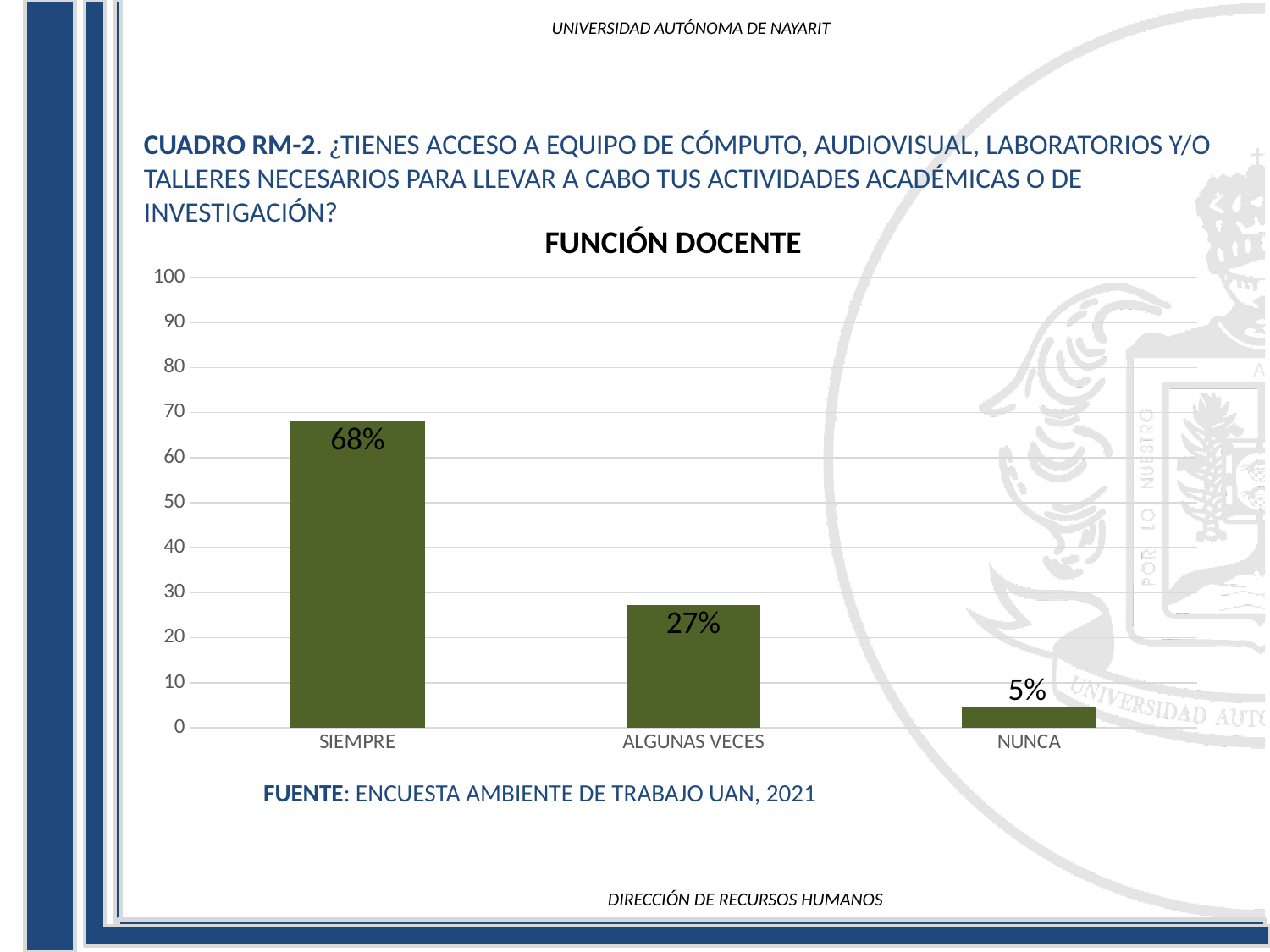
What kind of chart is shown on the slide? bar chart What is the value for ALGUNAS VECES? 27% Is the value for SIEMPRE greater or less than 60? greater Which category has the lowest value? NUNCA What is the value for NUNCA? 5% Which is larger, the value for ALGUNAS VECES or the value for NUNCA? ALGUNAS VECES What is the difference between the values for ALGUNAS VECES and NUNCA? 22% Which category has the highest value? SIEMPRE What is the difference between the values for SIEMPRE and ALGUNAS VECES? 41% What is the title of the chart? FUNCIÓN DOCENTE What is the value for SIEMPRE? 68% How many categories are shown on the x axis? 3